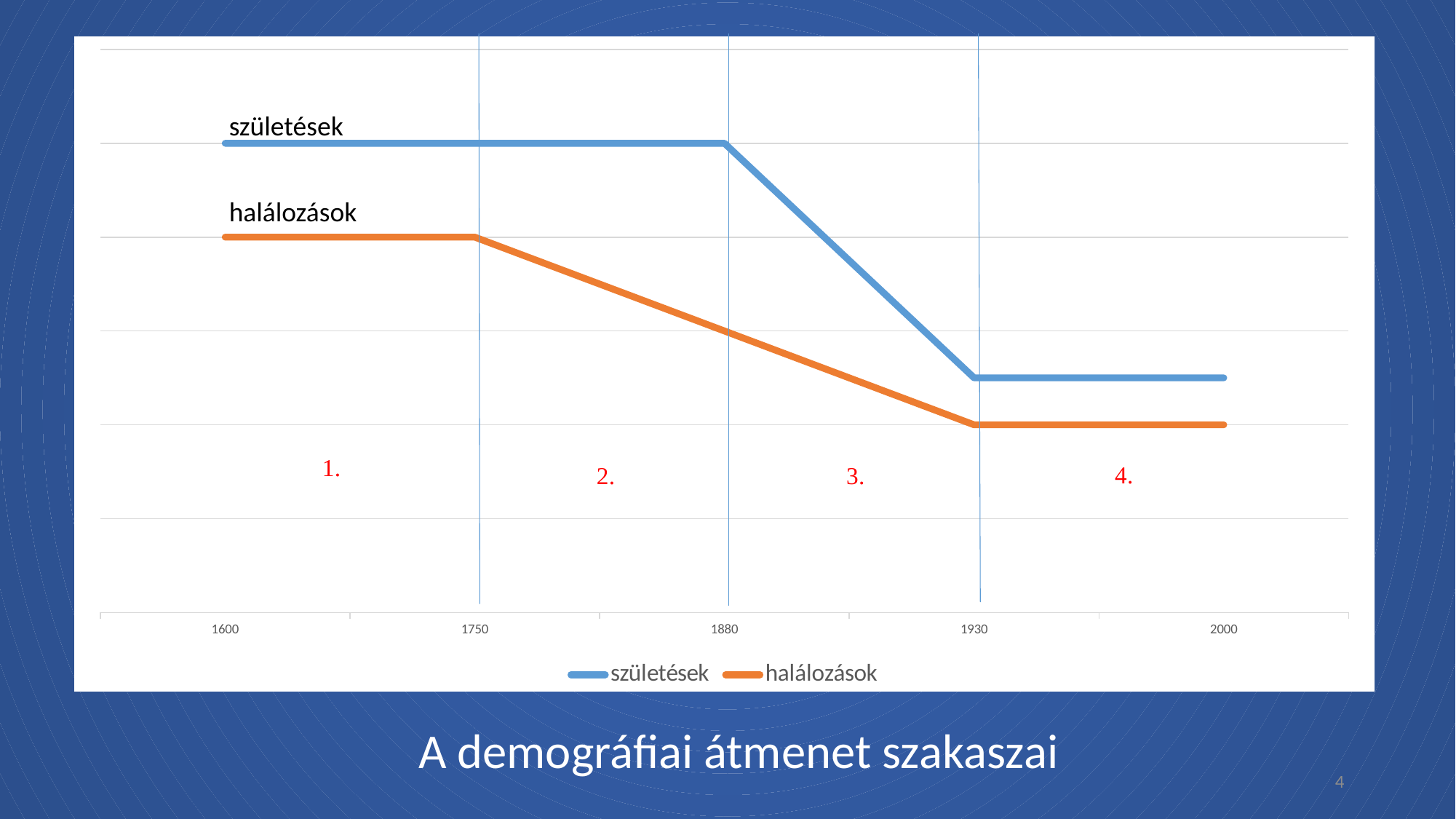
Which series is higher at 2000, születések or halálozások? születések Does the születések line rise, fall or stay flat between 1930 and 2000? stay flat Does the halálozások line rise or fall between 1750 and 1930? fall How many series does the legend list? 2 Which series is higher at 1600, születések or halálozások? születések Does the születések line rise or fall between 1880 and 1930? fall How many year labels are shown on the x axis? 5 What colour is the halálozások line? orange What is the title shown below the chart? A demográfiai átmenet szakaszai Which year label is the first on the x axis? 1600 What kind of chart is shown on the slide? line chart